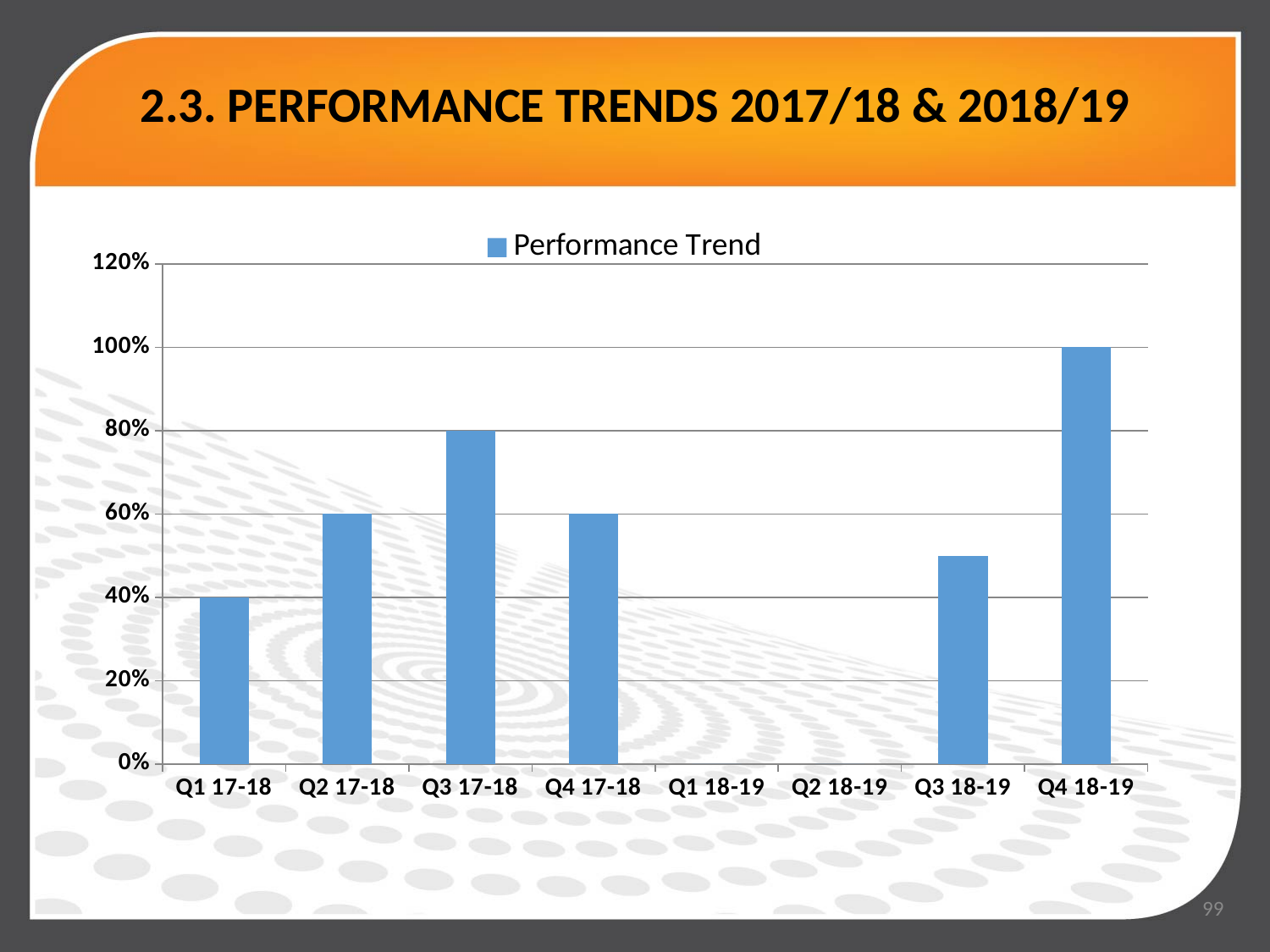
How many quarters are shown on the x axis? 8 Is the value for Q3 18-19 greater or less than 40%? greater What is the difference between the values for Q3 17-18 and Q1 17-18? 40% What is the value for Q2 17-18? 60% Which is larger, the value for Q2 17-18 or the value for Q3 18-19? Q2 17-18 What is the value for Q3 17-18? 80% Which quarter has the highest value? Q4 18-19 What kind of chart is shown on the slide? bar chart What is the value for Q1 17-18? 40% What is the value for Q4 18-19? 100% What is the name of the series shown in the legend? Performance Trend How many series does the legend list? 1